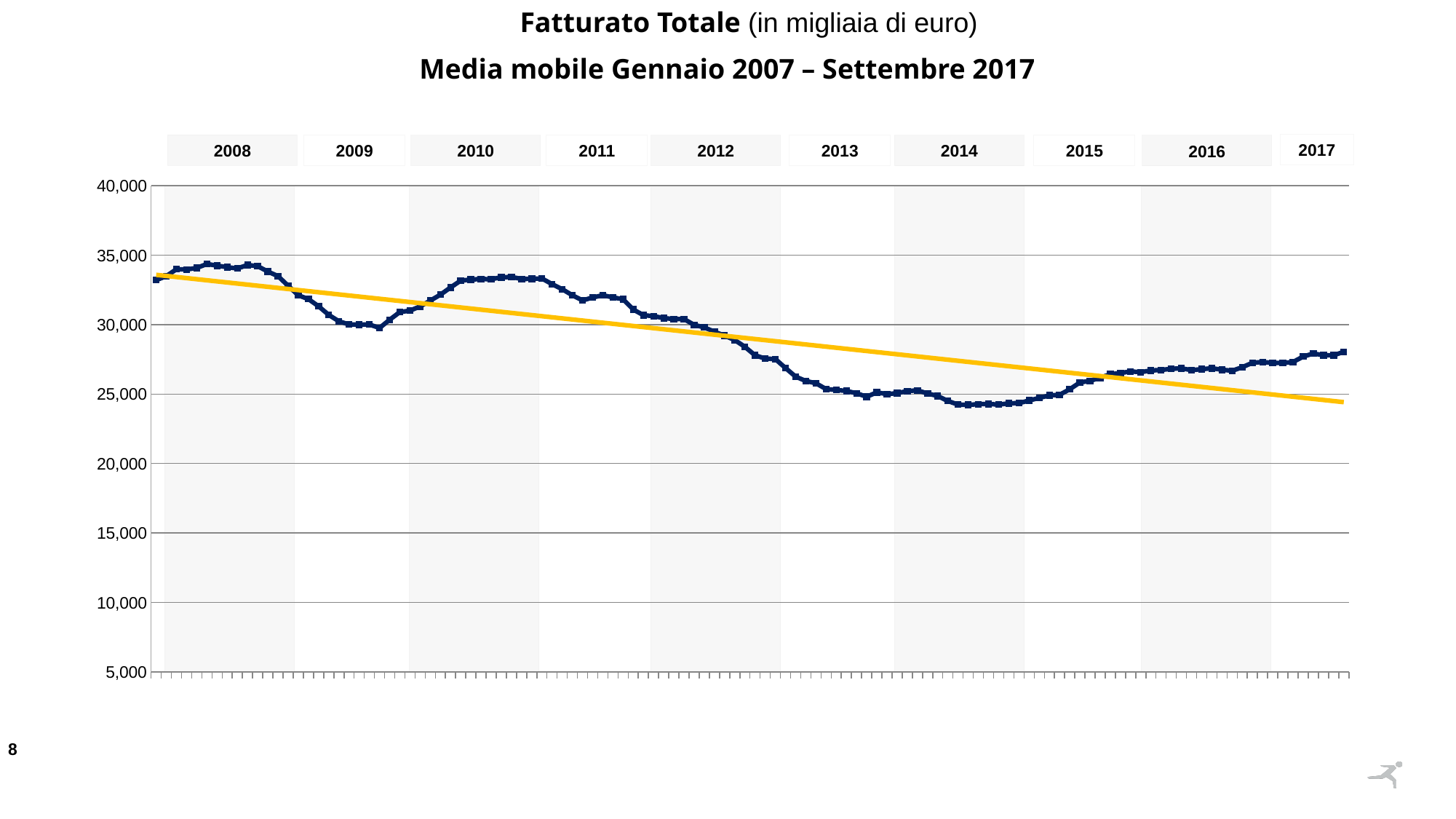
Is the moving-average value in the middle of 2014 greater or less than 25,000? less Is the moving-average value in 2008 larger or smaller than in 2016? larger Does the yellow trend line rise or fall from left to right? fall In which labelled year does the moving average reach its highest values? 2008 How many year labels are shown along the top of the chart? 10 Is the moving-average value during 2017 greater or less than 25,000? greater Is the moving-average value during 2013 greater or less than 30,000? less In which labelled year does the moving average reach its lowest values? 2014 What kind of chart is shown on the slide? line chart What is the title of the chart? Fatturato Totale (in migliaia di euro) Media mobile Gennaio 2007 – Settembre 2017